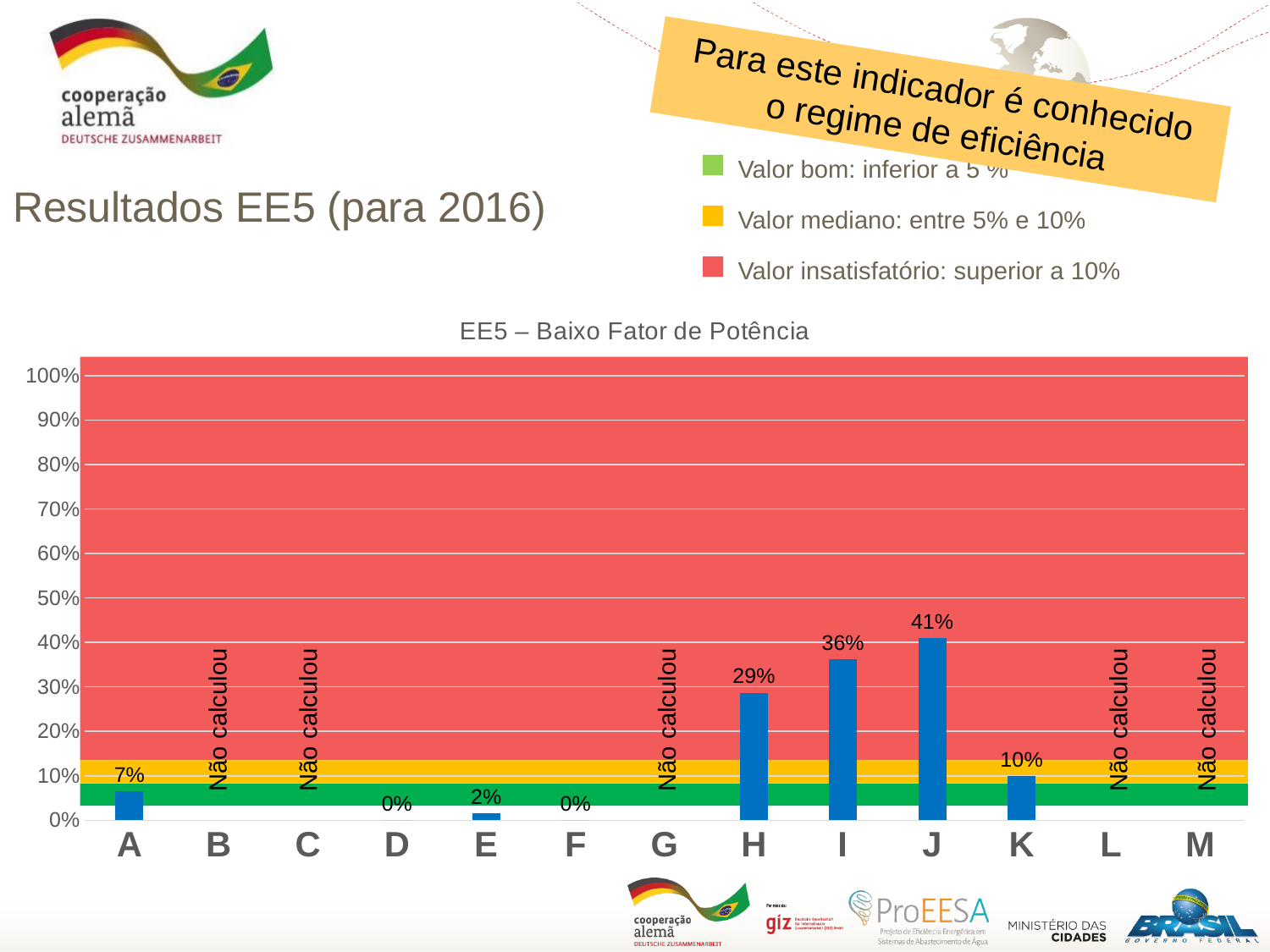
What kind of chart is the EE5 – Baixo Fator de Potência chart? Bar chart Which is larger in the EE5 – Baixo Fator de Potência chart, the value for I or the value for K? I What is the value for category H in the EE5 – Baixo Fator de Potência chart? 29% What is the difference between the values for H and A in the EE5 – Baixo Fator de Potência chart? 22% Which category has the highest value in the EE5 – Baixo Fator de Potência chart? J What is the value for category A in the EE5 – Baixo Fator de Potência chart? 7% What is the value for category J in the EE5 – Baixo Fator de Potência chart? 41% What is the title of the chart on the slide? EE5 – Baixo Fator de Potência What label is shown in place of a bar for category B in the EE5 – Baixo Fator de Potência chart? Não calculou How many categories are shown on the x axis of the EE5 – Baixo Fator de Potência chart? 13 What is the value for category K in the EE5 – Baixo Fator de Potência chart? 10% What is the difference between the values for J and I in the EE5 – Baixo Fator de Potência chart? 5%